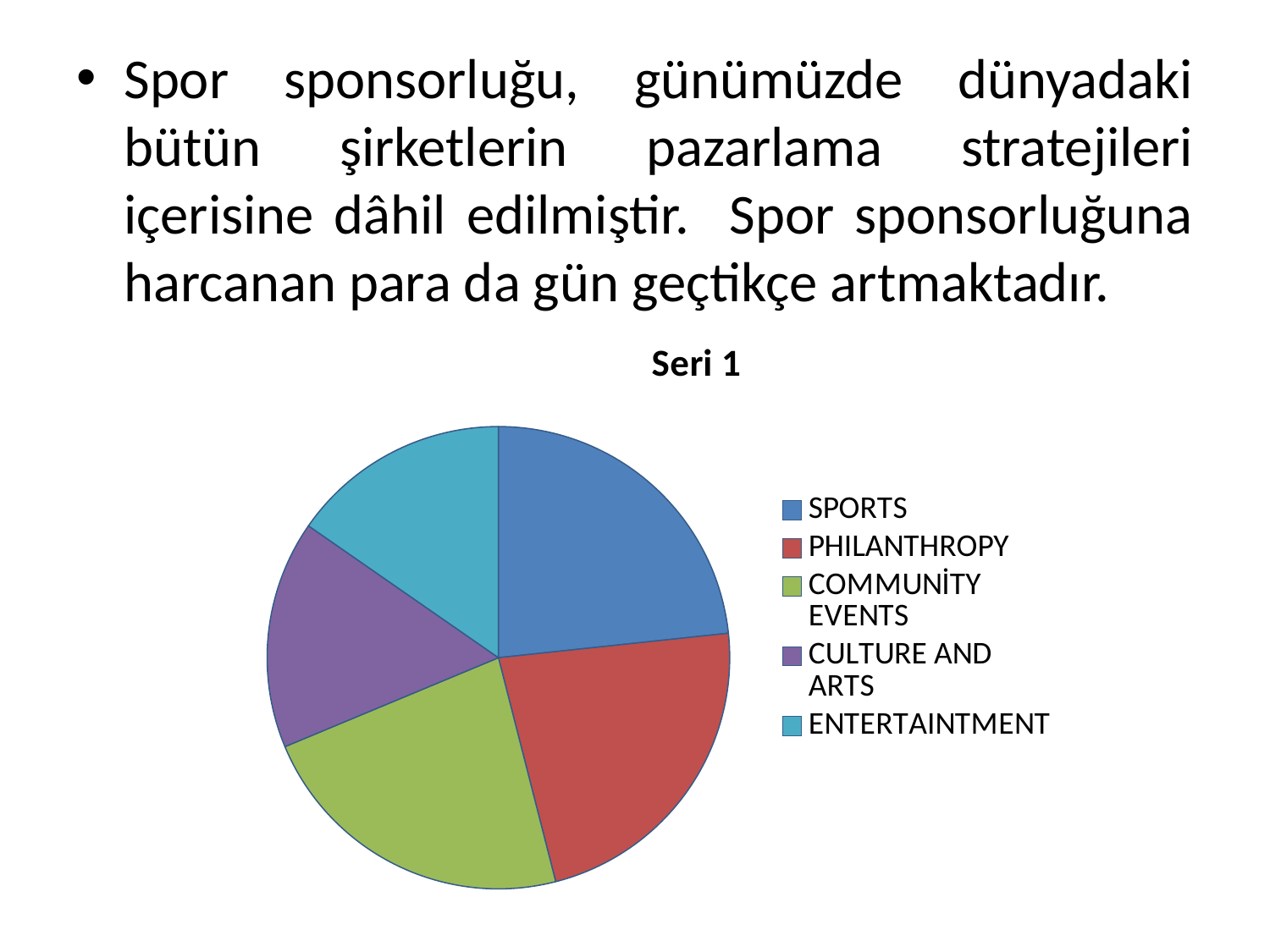
Which slice is larger in the pie chart, SPORTS or ENTERTAINTMENT? SPORTS What kind of chart is shown on the slide? pie chart Which legend entry is shown in blue in the pie chart? SPORTS How many slices does the pie chart have? 5 How many entries does the legend of the pie chart list? 5 Which slice is larger in the pie chart, ENTERTAINTMENT or PHILANTHROPY? PHILANTHROPY Which slice is larger in the pie chart, CULTURE AND ARTS or SPORTS? SPORTS What is the title of the pie chart? Seri 1